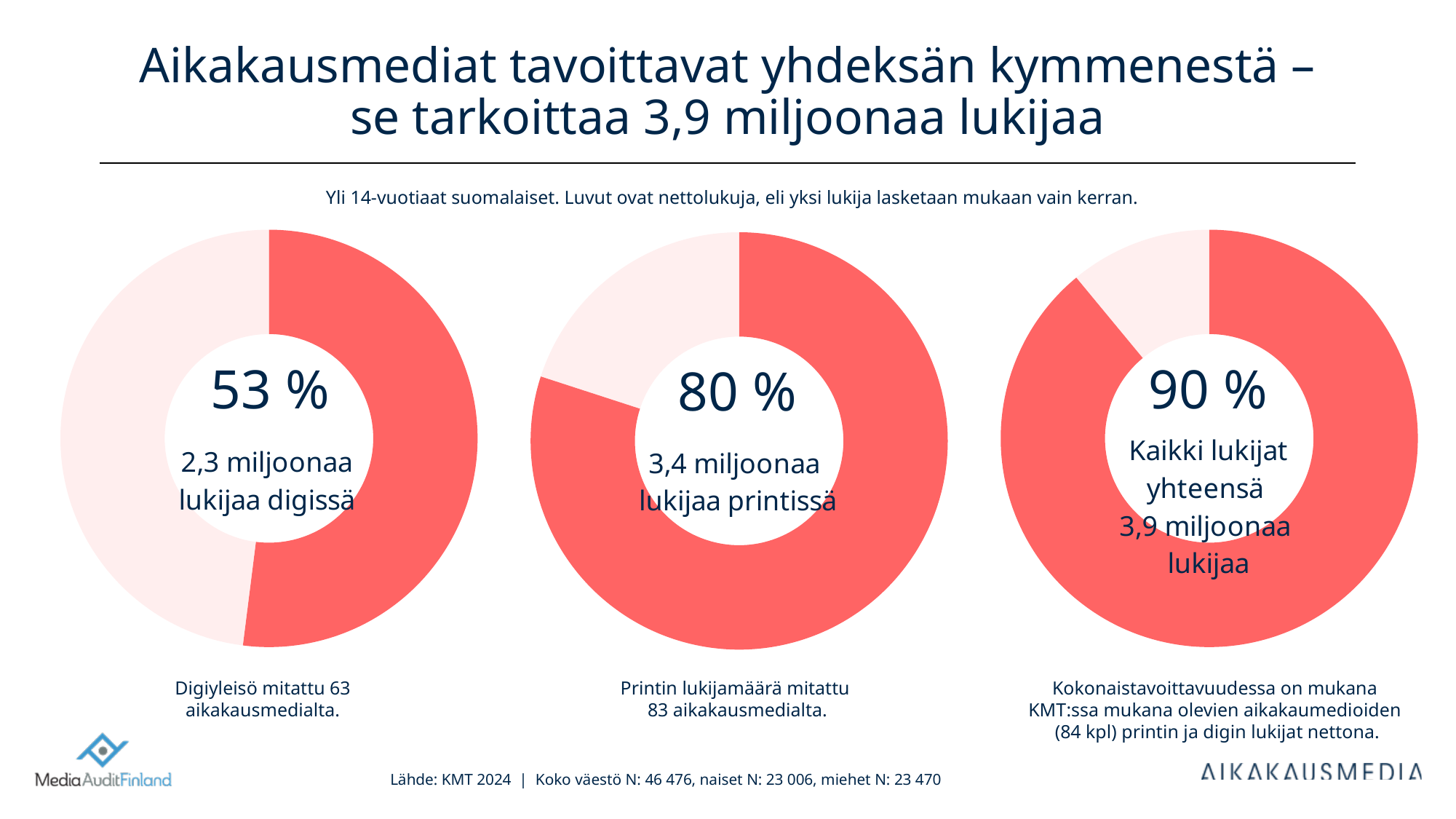
According to the right donut chart, how many million readers are there in total? 3,9 miljoonaa What is the difference in percentage points between the print reach (80 %) and the digital reach (53 %)? 27 percentage points How many donut charts are shown on the slide? 3 According to the middle donut chart, how many million readers are there in print? 3,4 miljoonaa In the middle donut chart, what percentage is shown for readers in print (lukijaa printissä)? 80 % In the right donut chart, what percentage is shown for all readers in total (Kaikki lukijat yhteensä)? 90 % Is the percentage in the middle donut chart (print) larger or smaller than the percentage in the left donut chart (digital)? Larger In the left donut chart, what percentage is shown for readers in digital (lukijaa digissä)? 53 % Which of the three donut charts shows the lowest percentage? The left chart (lukijaa digissä), 53 % According to the left donut chart, how many million readers are there in digital? 2,3 miljoonaa What type of chart is used to show the reach figures on the slide? Donut (pie) chart Which of the three donut charts shows the highest percentage? The right chart (Kaikki lukijat yhteensä), 90 %